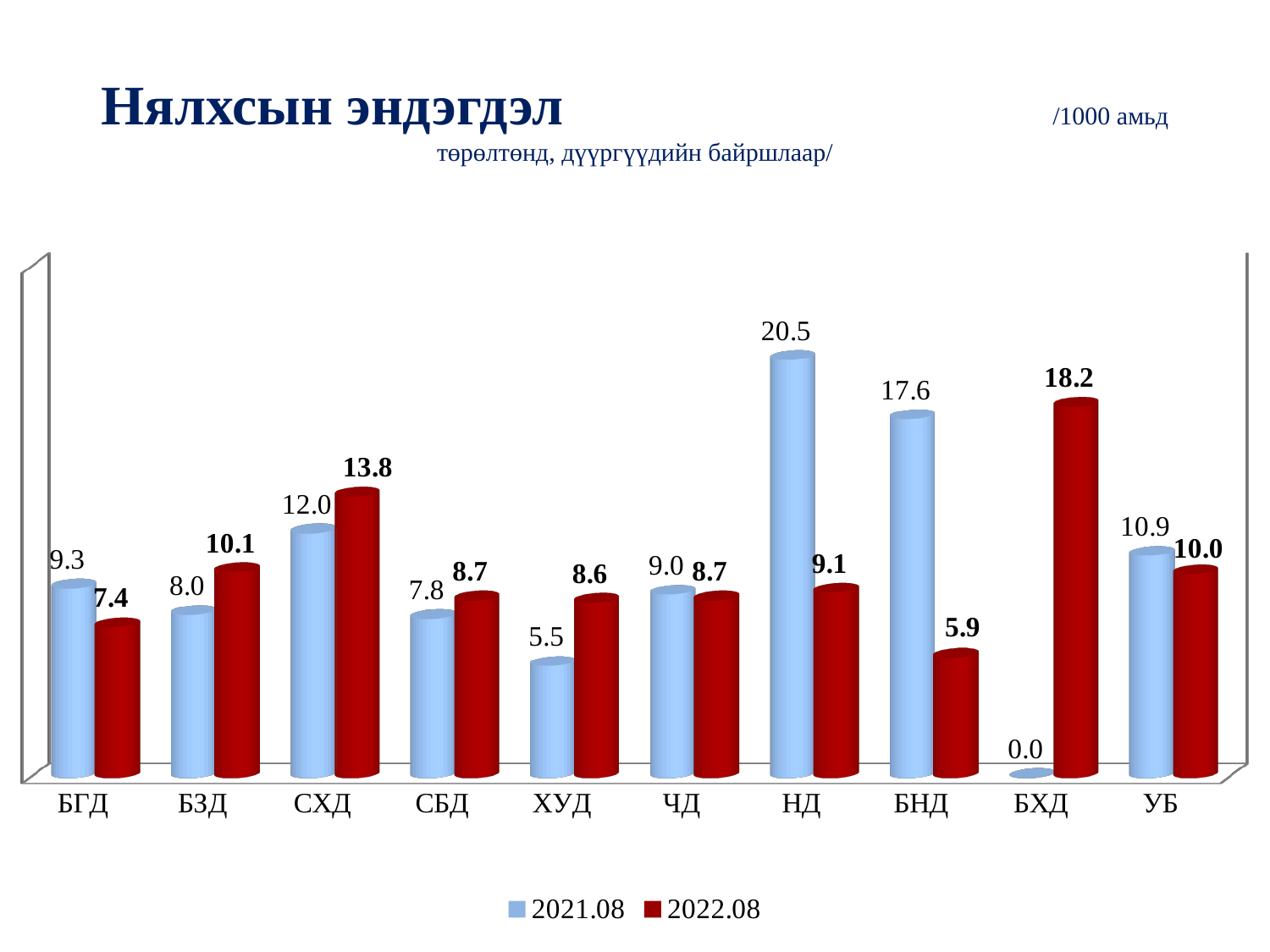
What is the difference between the 2021.08 and 2022.08 values for БНД? 11.7 What is the 2022.08 value for БХД? 18.2 What is the 2021.08 value for НД? 20.5 What is the 2022.08 value for БНД? 5.9 What kind of chart is shown on the slide? Bar chart What is the 2021.08 value for УБ? 10.9 Which is larger for СХД, the 2021.08 value or the 2022.08 value? 2022.08 Which category has the lowest 2021.08 value? БХД Which category has the highest 2021.08 value? НД How many series does the legend list? 2 How many categories are shown on the x axis? 10 Which category has the highest 2022.08 value? БХД